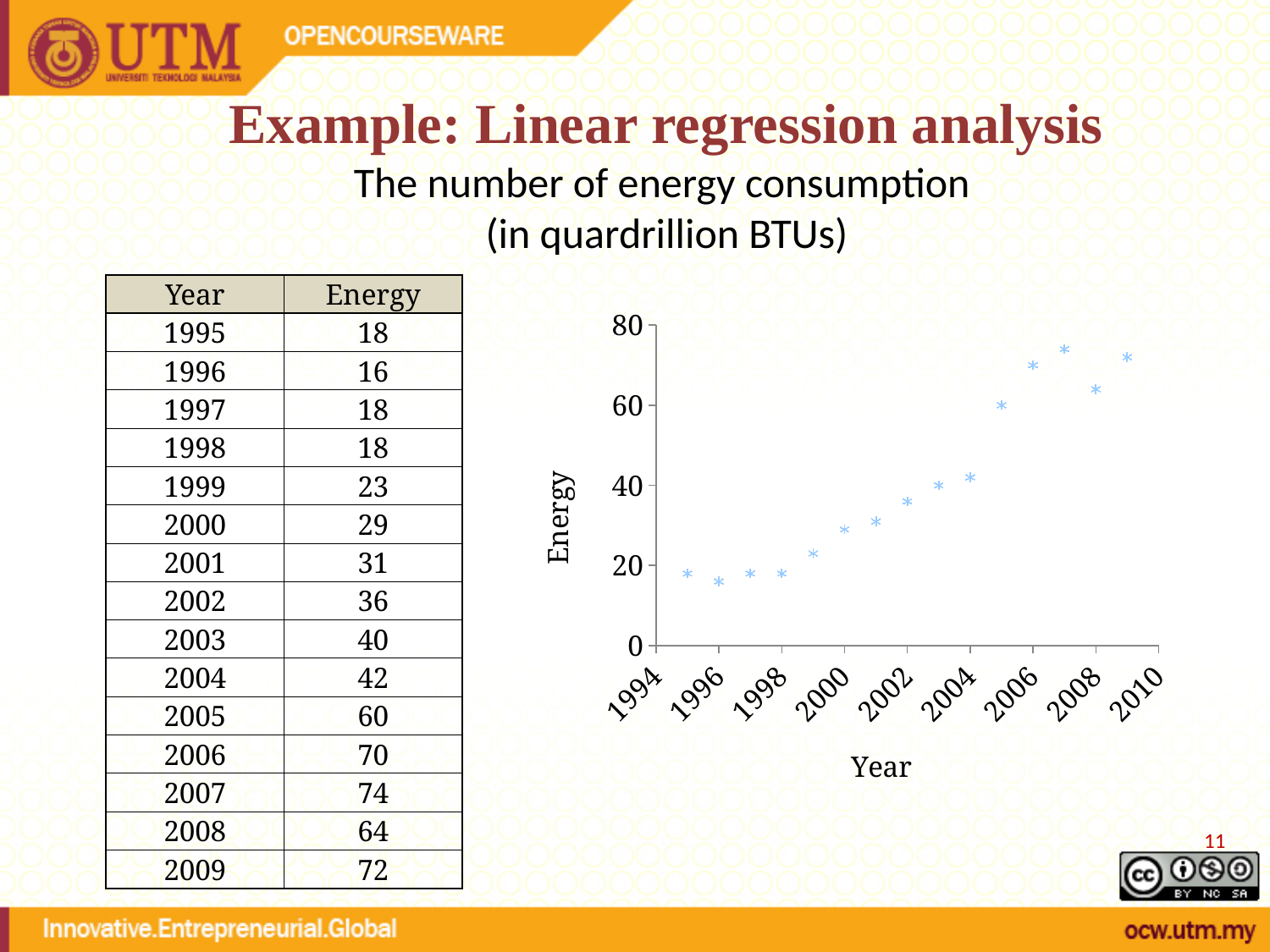
Which is larger, the energy value for 2008 or for 2009? 2009 What kind of chart is shown on the slide? scatter chart What is the difference between the energy values for 2007 and 2008? 10 Do the energy values generally rise or fall from 1995 to 2009? rise What is the label on the vertical axis of the chart? Energy How many data points are plotted in the chart? 15 What is the energy value for 2007? 74 Is the energy value for 2005 greater or less than 40? greater Which year has the lowest energy value in the chart? 1996 What is the energy value for 2005? 60 Is the energy value for 1999 greater or less than 40? less Which year has the highest energy value in the chart? 2007